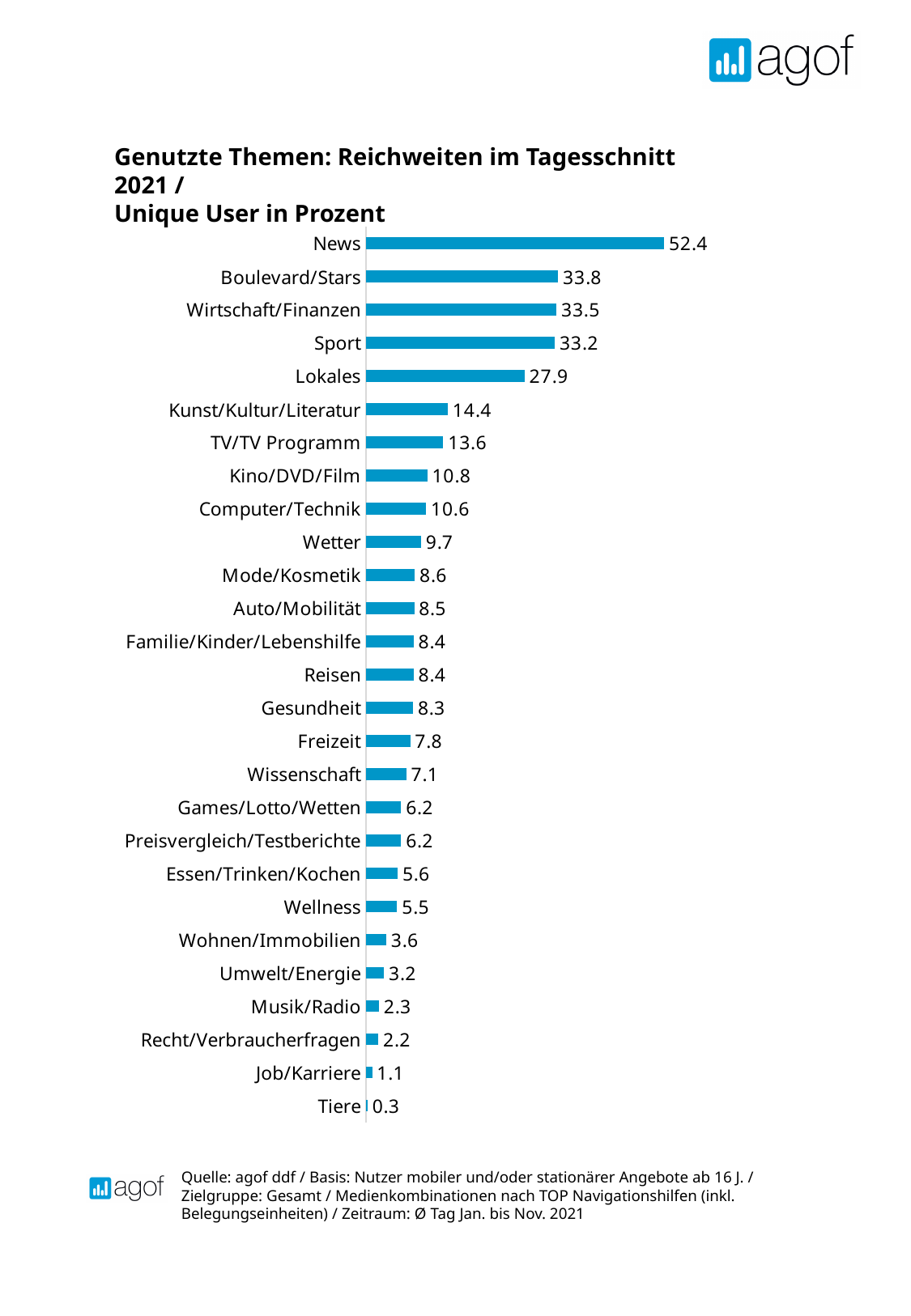
What is the value for Lokales? 27.9 What is the difference between the values for News and Boulevard/Stars? 18.6 What kind of chart is shown on the slide? Bar chart Which category has the lowest value? Tiere What is the difference between the values for Kunst/Kultur/Literatur and TV/TV Programm? 0.8 What is the title of the chart? Genutzte Themen: Reichweiten im Tagesschnitt 2021 / Unique User in Prozent What is the value for Wetter? 9.7 Which category has the highest value? News What is the value for Wohnen/Immobilien? 3.6 What is the value for News? 52.4 Which is larger, the value for Sport or the value for Lokales? Sport How many categories are shown in the chart? 27